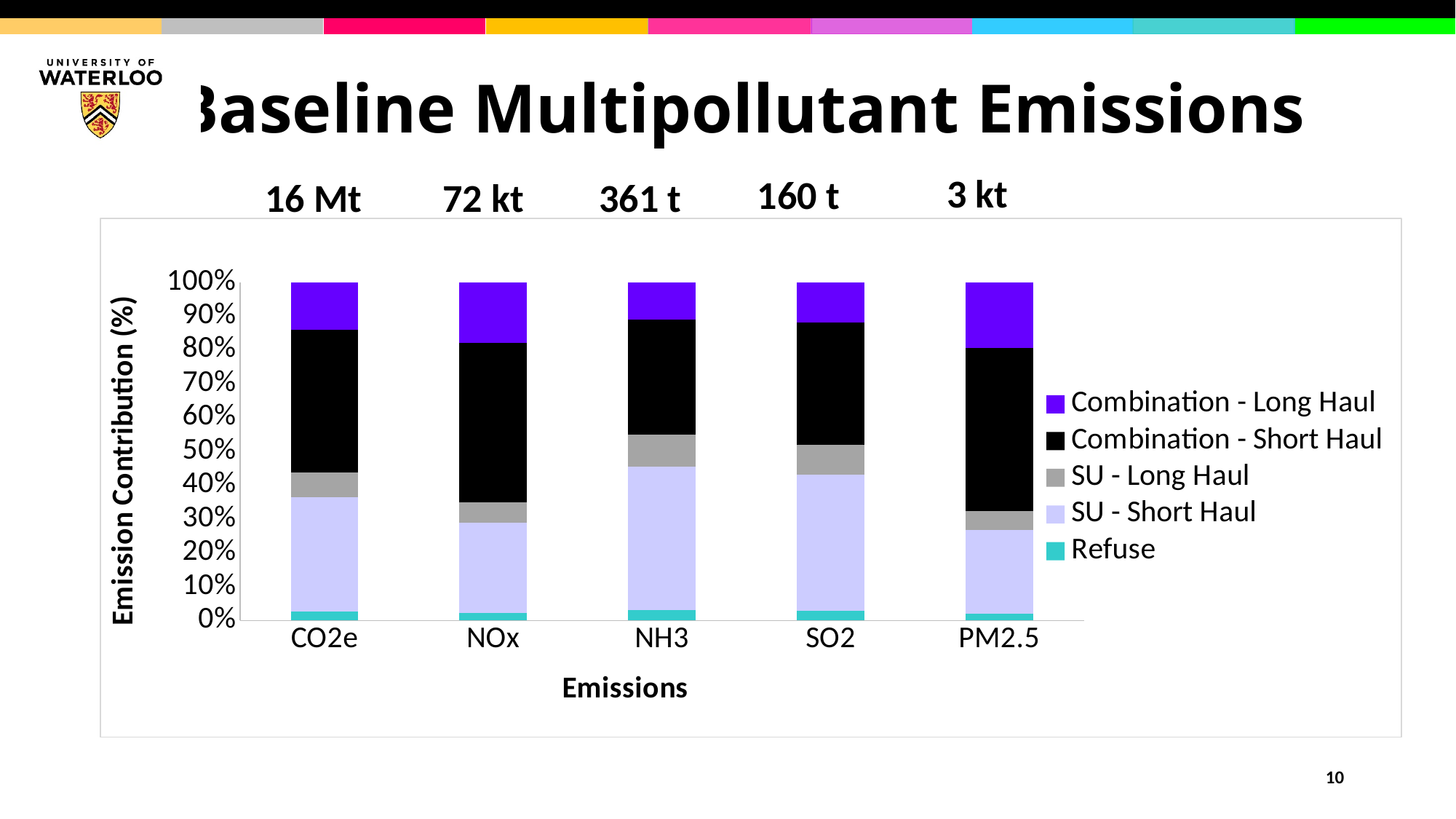
What total is printed above the NOx bar? 72 kt What total is printed above the PM2.5 bar? 3 kt Is the cumulative top of the Combination - Short Haul segment for CO2e greater or less than 80%? greater What is the label on the y axis of the chart? Emission Contribution (%) How many series does the legend list? 5 What total is printed above the CO2e bar? 16 Mt What kind of chart is shown on the slide? Stacked bar chart Which has the larger Combination - Long Haul share, PM2.5 or NH3? PM2.5 Is the cumulative top of the SU - Short Haul segment for NH3 greater or less than 40%? greater How many emission categories are plotted along the x axis? 5 Which has the larger SU - Short Haul share, NH3 or PM2.5? NH3 What total is printed above the NH3 bar? 361 t